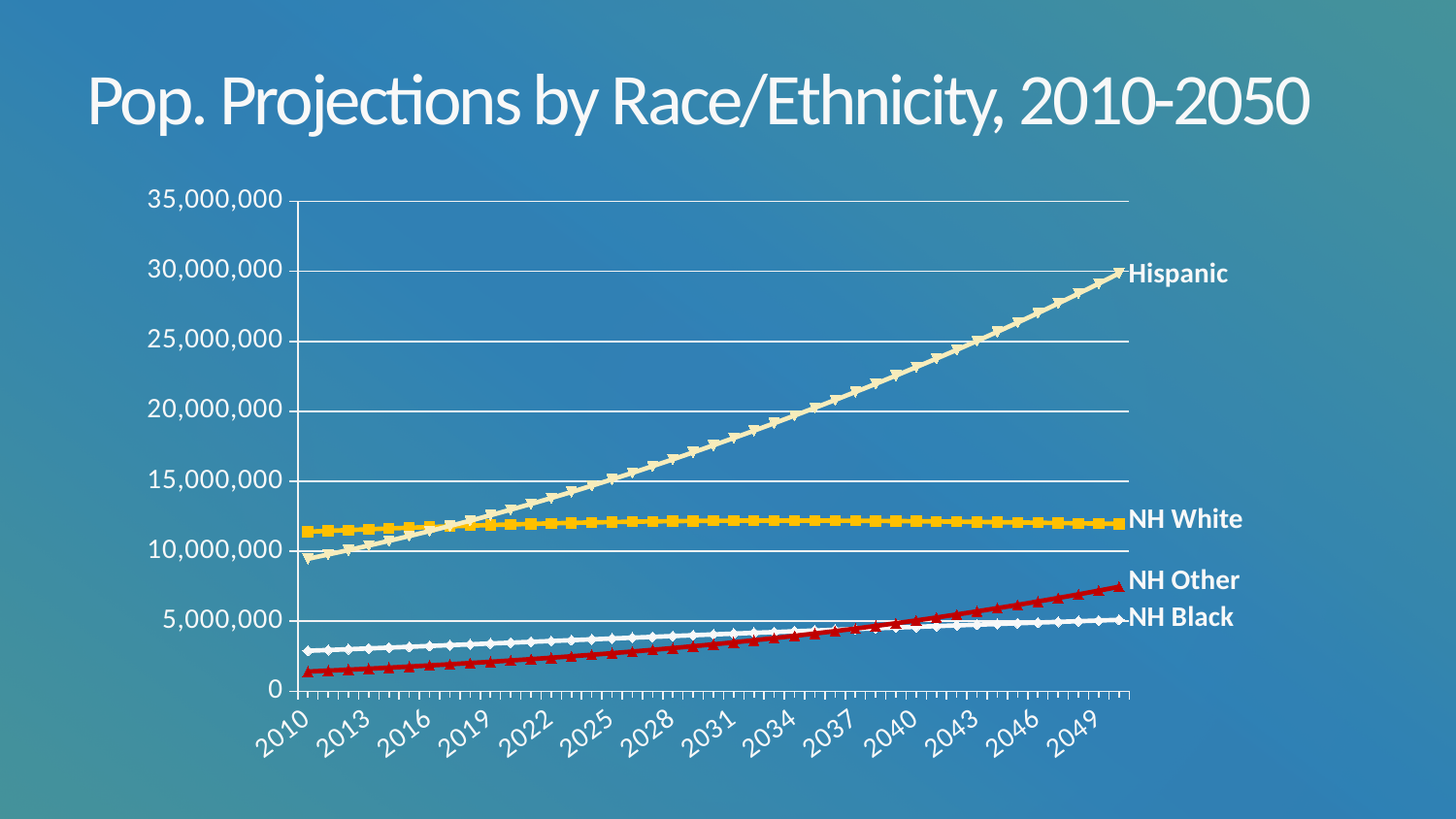
In 2010, which is larger: NH Black or NH Other? NH Black Which series has the lowest value in 2050? NH Black Is the value for NH Black in 2010 greater or less than 5,000,000? less Does the Hispanic series rise or fall from 2010 to 2050? Rise Does the NH Other series rise or fall from 2010 to 2050? Rise Is the value for Hispanic in 2050 greater or less than 25,000,000? greater What is the title of the chart? Pop. Projections by Race/Ethnicity, 2010-2050 What kind of chart is shown on the slide? Line chart How many series are plotted on the chart? 4 Which series has the highest value in 2050? Hispanic Which series has the lowest value in 2010? NH Other Is the value for NH Other in 2050 greater or less than 5,000,000? greater